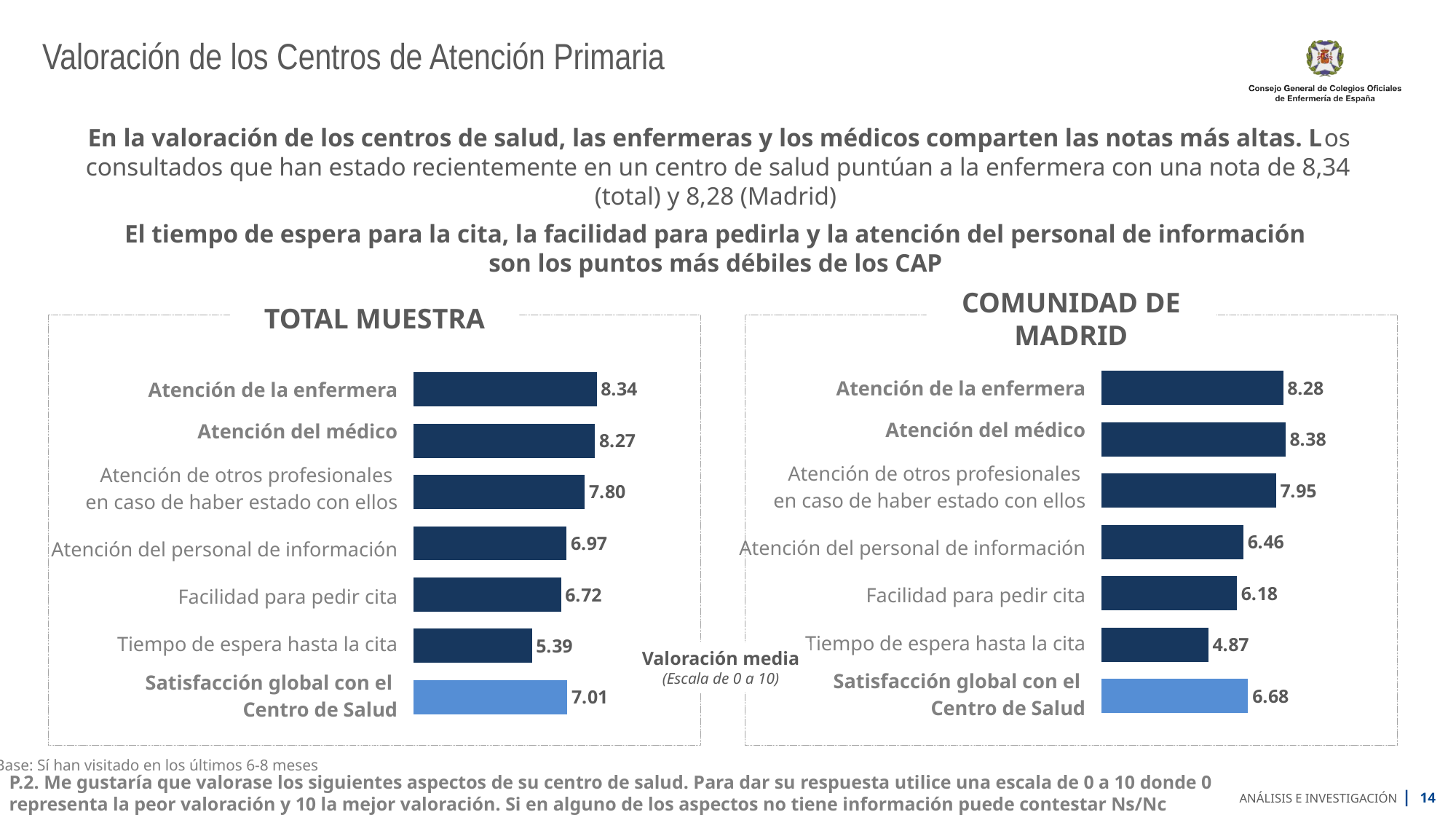
In the COMUNIDAD DE MADRID chart, what is the difference between Atención del personal de información and Facilidad para pedir cita? 0.28 In the TOTAL MUESTRA chart, how many categories are plotted? 7 In the TOTAL MUESTRA chart, what is the value for Facilidad para pedir cita? 6.72 In the COMUNIDAD DE MADRID chart, which category has the highest value? Atención del médico What type of chart is the COMUNIDAD DE MADRID chart? Bar chart In the COMUNIDAD DE MADRID chart, what is the value for Satisfacción global con el Centro de Salud? 6.68 In the TOTAL MUESTRA chart, which category has the lowest value? Tiempo de espera hasta la cita In the COMUNIDAD DE MADRID chart, what is the value for Tiempo de espera hasta la cita? 4.87 Which is larger: Satisfacción global con el Centro de Salud in the TOTAL MUESTRA chart or in the COMUNIDAD DE MADRID chart? TOTAL MUESTRA In the TOTAL MUESTRA chart, what is the value for Atención de la enfermera? 8.34 In the TOTAL MUESTRA chart, which bar is shown in a lighter blue colour than the others? Satisfacción global con el Centro de Salud In the TOTAL MUESTRA chart, what is the difference between Atención de la enfermera and Atención del médico? 0.07